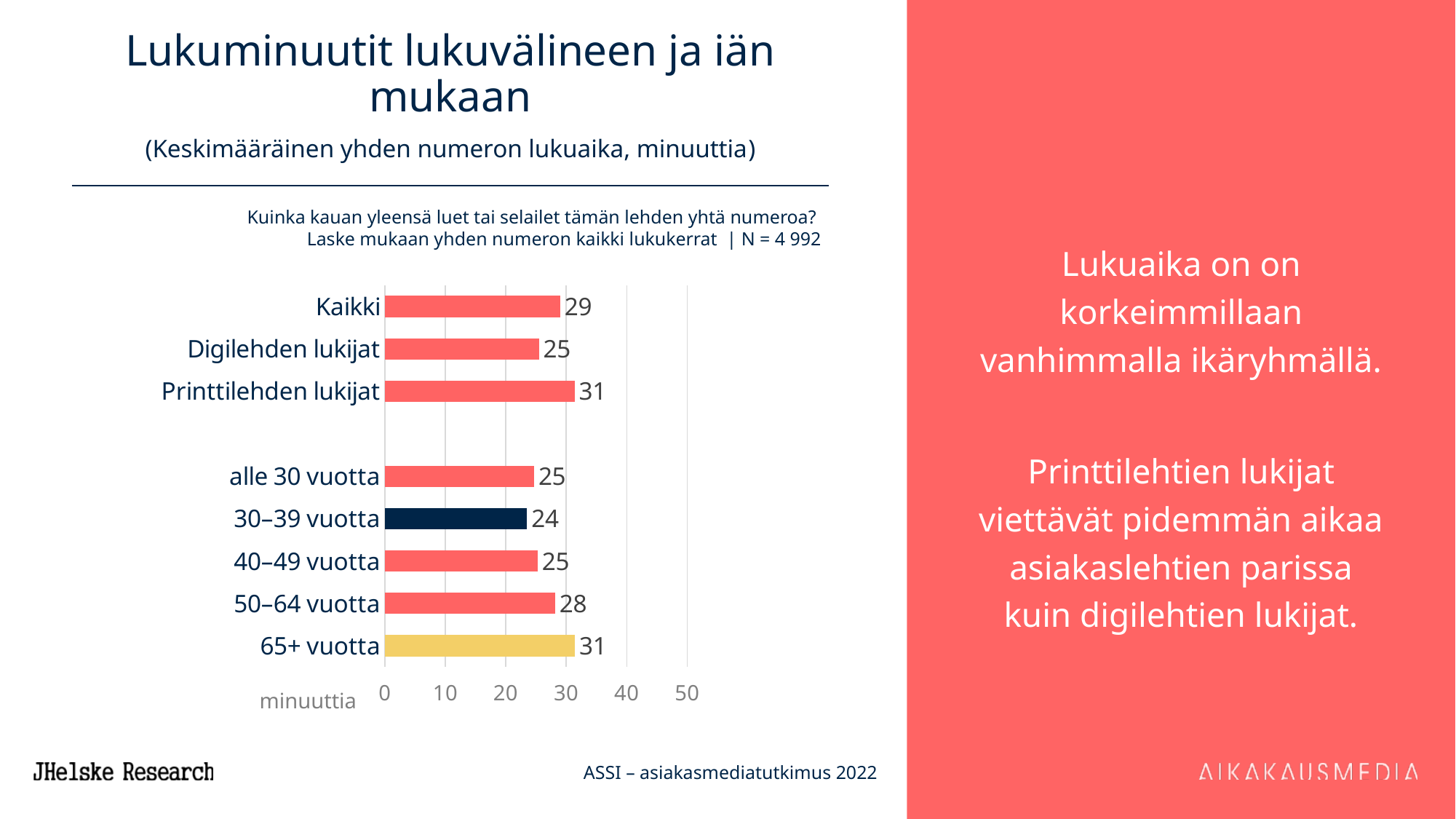
What unit is shown on the x axis of the chart? minuuttia What is the value for 50–64 vuotta? 28 Among the age groups, which has the highest value? 65+ vuotta Is the value for Printtilehden lukijat greater or less than 40? less What is the value for 65+ vuotta? 31 How many categories are shown in the chart? 8 What is the value for Kaikki? 29 What is the difference between Printtilehden lukijat and Digilehden lukijat? 6 What kind of chart is shown on the slide? bar chart Which is larger, the value for 50–64 vuotta or the value for 40–49 vuotta? 50–64 vuotta What is the value for Digilehden lukijat? 25 Which category has the lowest value? 30–39 vuotta